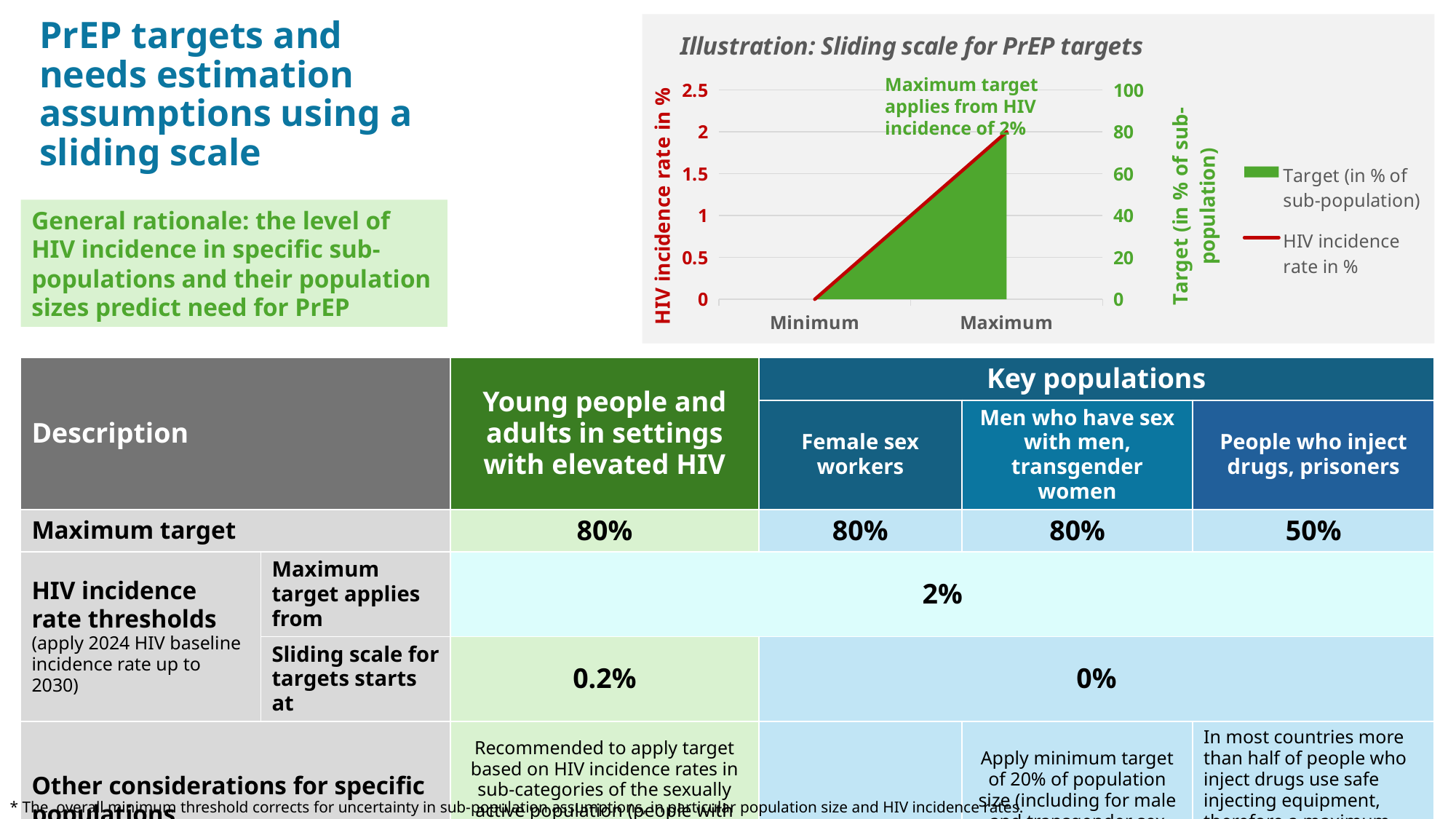
What is the label of the left vertical axis of the chart? HIV incidence rate in % Which category has the higher Target (in % of sub-population) on the chart, Minimum or Maximum? Maximum What are the two categories on the x axis of the chart? Minimum and Maximum What is the HIV incidence rate in % at the Minimum category on the chart? 0 Do the values on the chart rise or fall from Minimum to Maximum? rise How many categories are shown on the x axis of the chart? 2 What is the title of the chart on the slide? Illustration: Sliding scale for PrEP targets Is the Target (in % of sub-population) at Maximum greater or less than 60? greater According to the chart annotation, from what HIV incidence rate does the maximum target apply? 2% How many series does the chart legend list? 2 What is the HIV incidence rate in % at the Maximum category on the chart? 2 What is the Target (in % of sub-population) at the Maximum category on the chart? 80